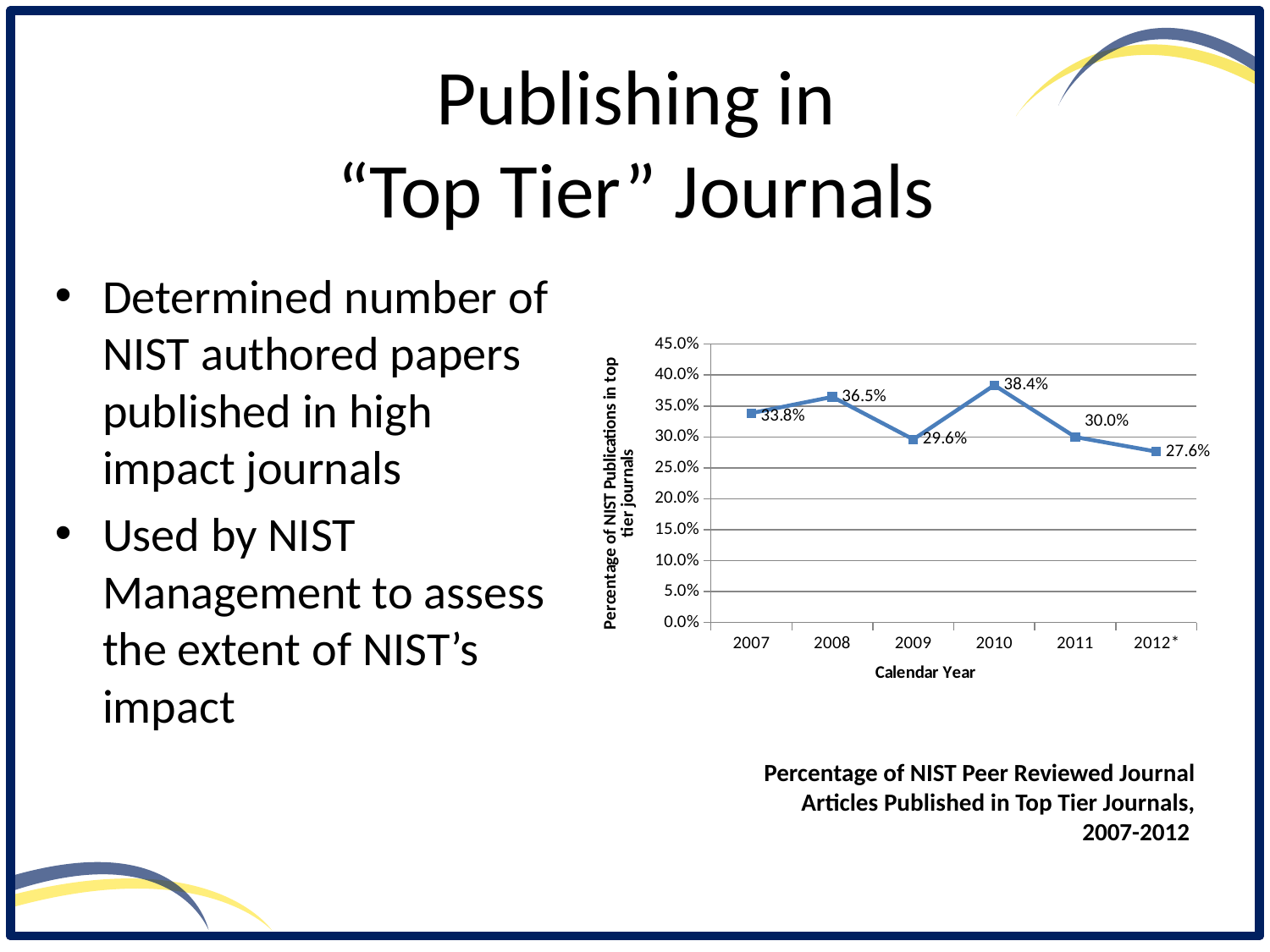
What is the label of the x axis of the chart? Calendar Year What is the value shown for 2012*? 27.6% Does the value rise or fall from 2010 to 2012*? fall How many calendar years are plotted on the x axis? 6 What kind of chart is shown on the slide? line chart Which year has a higher value, 2008 or 2011? 2008 Which calendar year has the highest percentage of NIST publications in top tier journals? 2010 Is the value for 2009 greater or less than 30.0%? less What is the value shown for 2007? 33.8% What percentage of NIST publications were in top tier journals in 2010? 38.4% What is the difference between the 2010 value and the 2009 value? 8.8% Which calendar year has the lowest percentage of NIST publications in top tier journals? 2012*